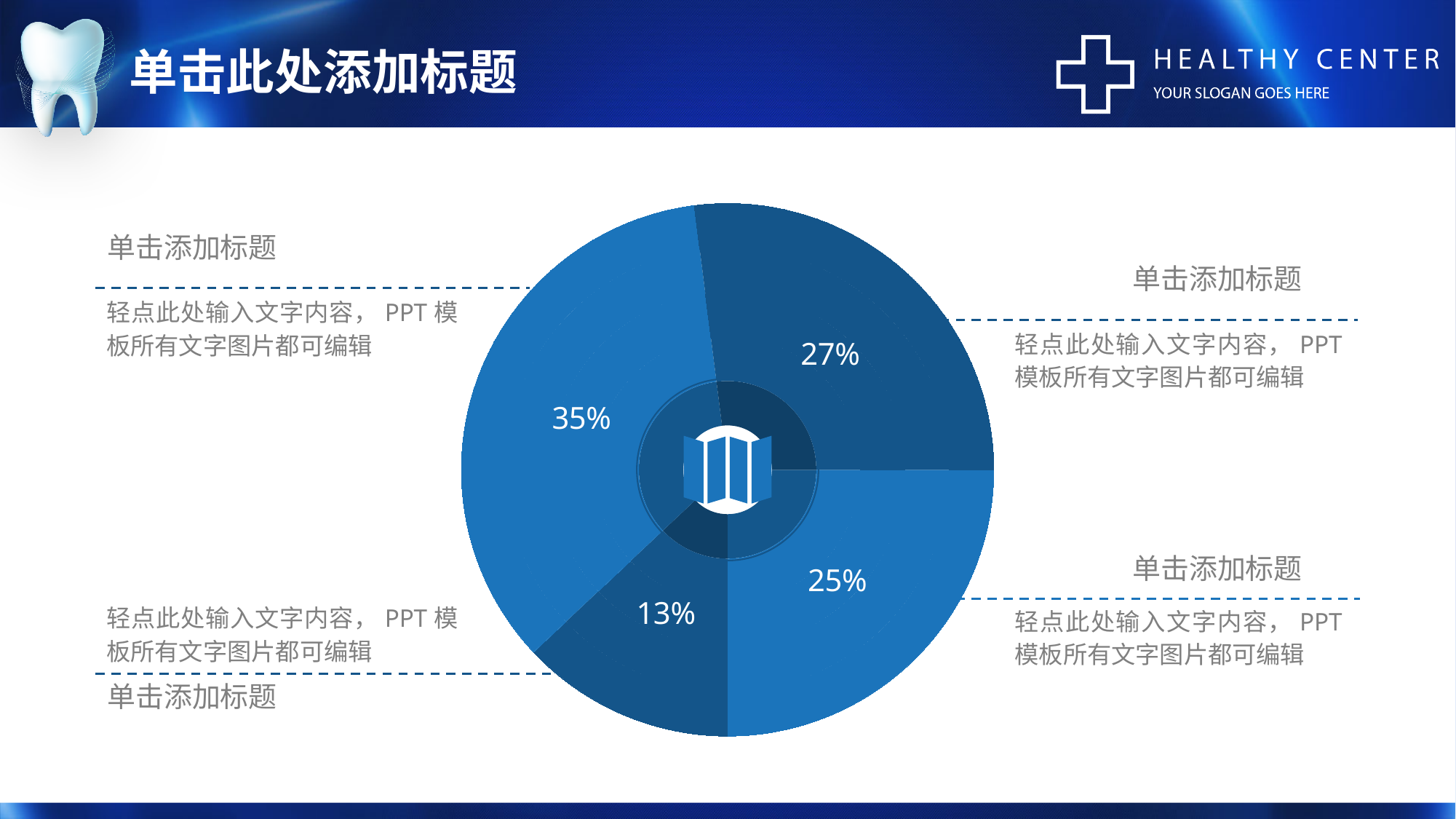
What kind of chart is shown on the slide? pie chart What value is shown on the left slice of the pie chart? 35% What value is shown on the bottom-right slice of the pie chart? 25% What do the four slice values of the pie chart add up to? 100% What is the value of the largest slice in the pie chart? 35% What colour family are the slices of the pie chart drawn in? shades of blue What value is shown on the top-right slice of the pie chart? 27% How many slices does the pie chart have? 4 What is the value of the smallest slice in the pie chart? 13% What is the difference between the largest and smallest slices of the pie chart? 22 percentage points Which is larger, the top-right slice or the bottom-right slice of the pie chart? the top-right slice (27%) What value is shown on the bottom-left slice of the pie chart? 13%